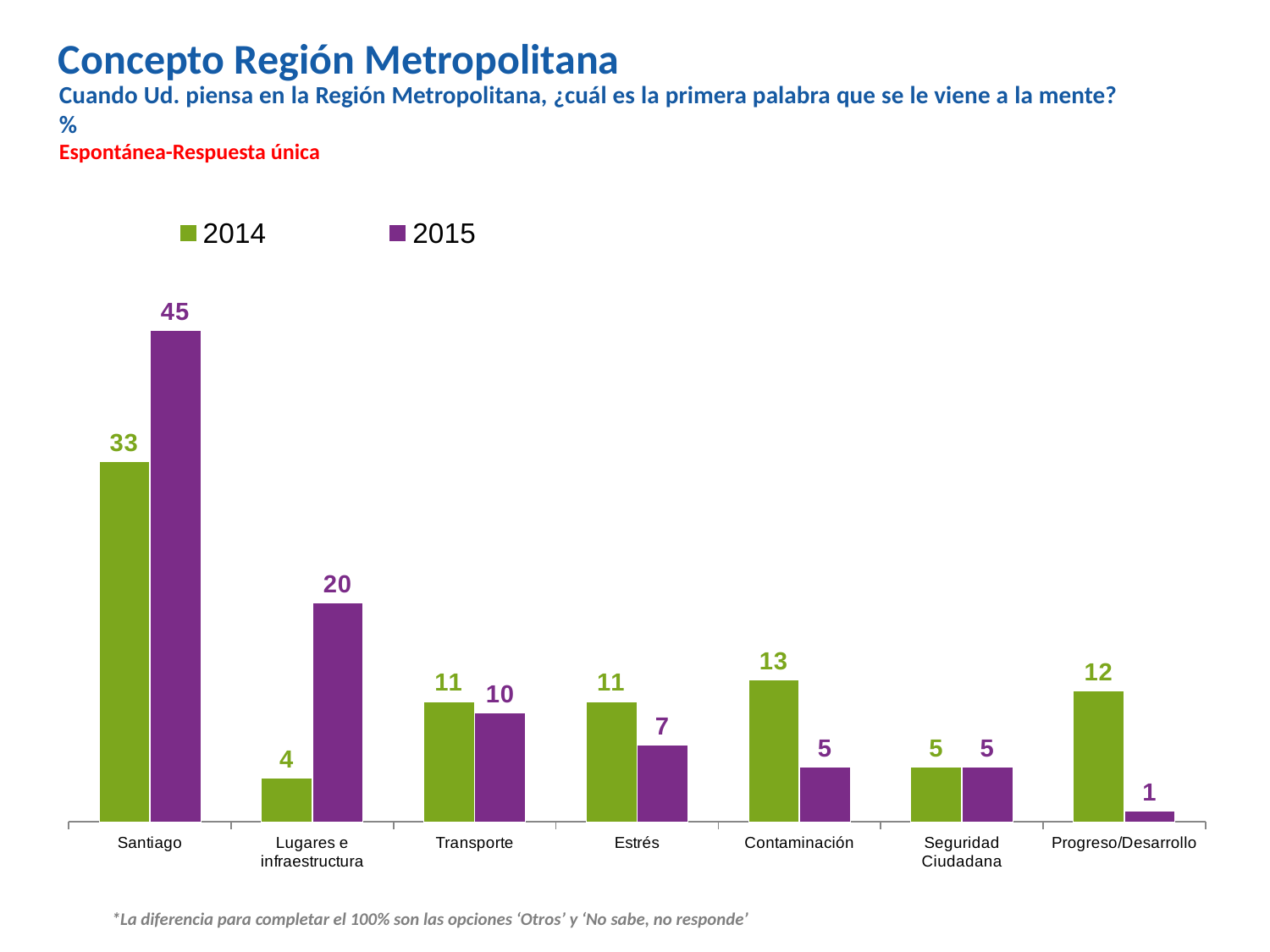
What is the difference between the 2015 and 2014 values for Santiago? 12 What is the 2015 value for Santiago? 45 What is the difference between the 2014 and 2015 values for Contaminación? 8 How many categories are shown on the x axis? 7 What is the 2015 value for Estrés? 7 What kind of chart is shown on the slide? Bar chart How many series does the legend list? 2 Which is larger for Lugares e infraestructura, the 2014 value or the 2015 value? 2015 Which category has the lowest 2015 value? Progreso/Desarrollo What is the 2014 value for Lugares e infraestructura? 4 Which category has the highest 2014 value? Santiago Which colour represents the 2015 series? Purple